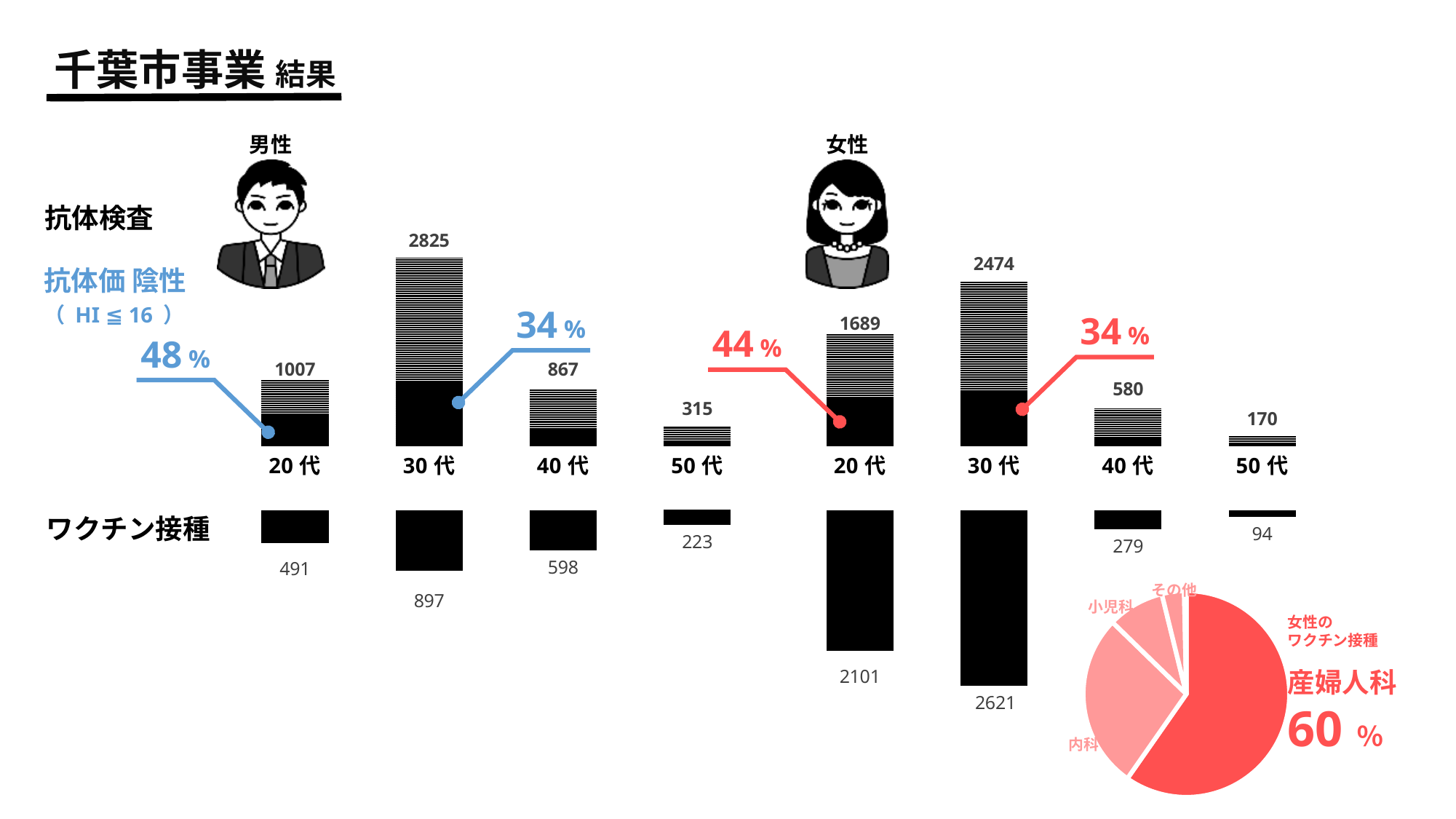
In the ワクチン接種 chart, what is the difference between 女性 20代 and 女性 40代? 1822 In the ワクチン接種 chart, which is larger: 男性 30代 or 男性 40代? 男性 30代 What kind of chart is used for 女性のワクチン接種 at the bottom right? pie chart In the 抗体検査 chart, what percentage of 男性 20代 is 抗体価 陰性? 48% In the ワクチン接種 chart, what is the value for 女性 30代? 2621 In the 抗体検査 chart, what is the difference between 男性 30代 and 男性 40代? 1958 In the pie chart, what share does 産婦人科 have of 女性のワクチン接種? 60% In the 抗体検査 chart, what is the value for 男性 30代? 2825 In the 抗体検査 chart, which age group has the lowest value among 男性? 50代 In the 抗体検査 chart, what is the value for 女性 20代? 1689 In the 抗体検査 chart, what percentage of 女性 20代 is 抗体価 陰性? 44% In the 抗体検査 chart, which age group has the highest value among 女性? 30代